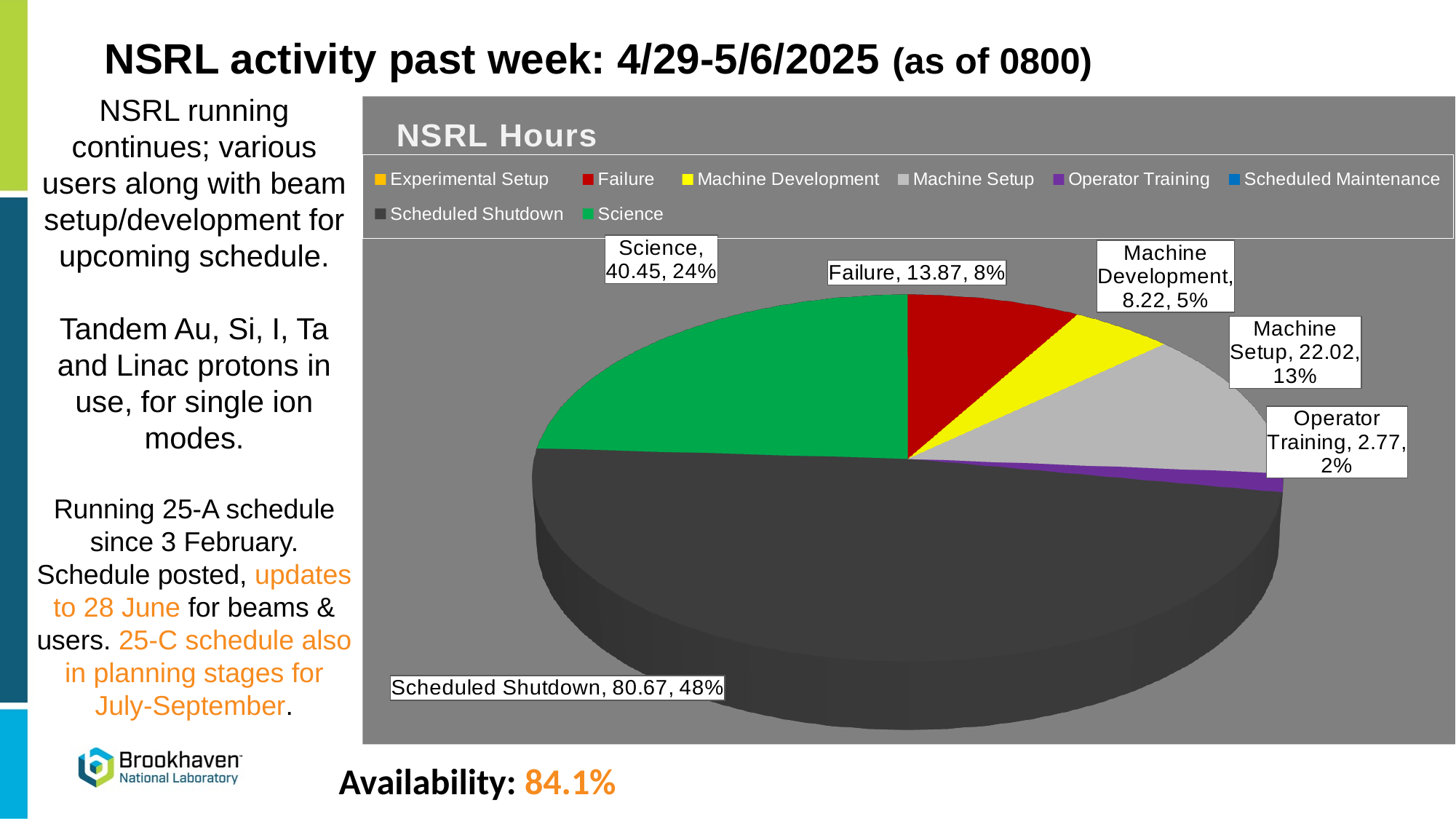
How many entries does the chart legend list? 8 How many slices of the pie have data labels? 6 How many hours are shown for Scheduled Shutdown? 80.67 How many hours are shown for Machine Setup? 22.02 Which category has the largest slice of the pie? Scheduled Shutdown What is the title of the chart? NSRL Hours How many hours are shown for Science? 40.45 What percentage share of the pie does Machine Development have? 5% What type of chart is shown on the slide? pie chart What percentage share of the pie does Failure have? 8% Which labeled category has the smallest slice of the pie? Operator Training What is the difference in hours between Scheduled Shutdown and Science? 40.22